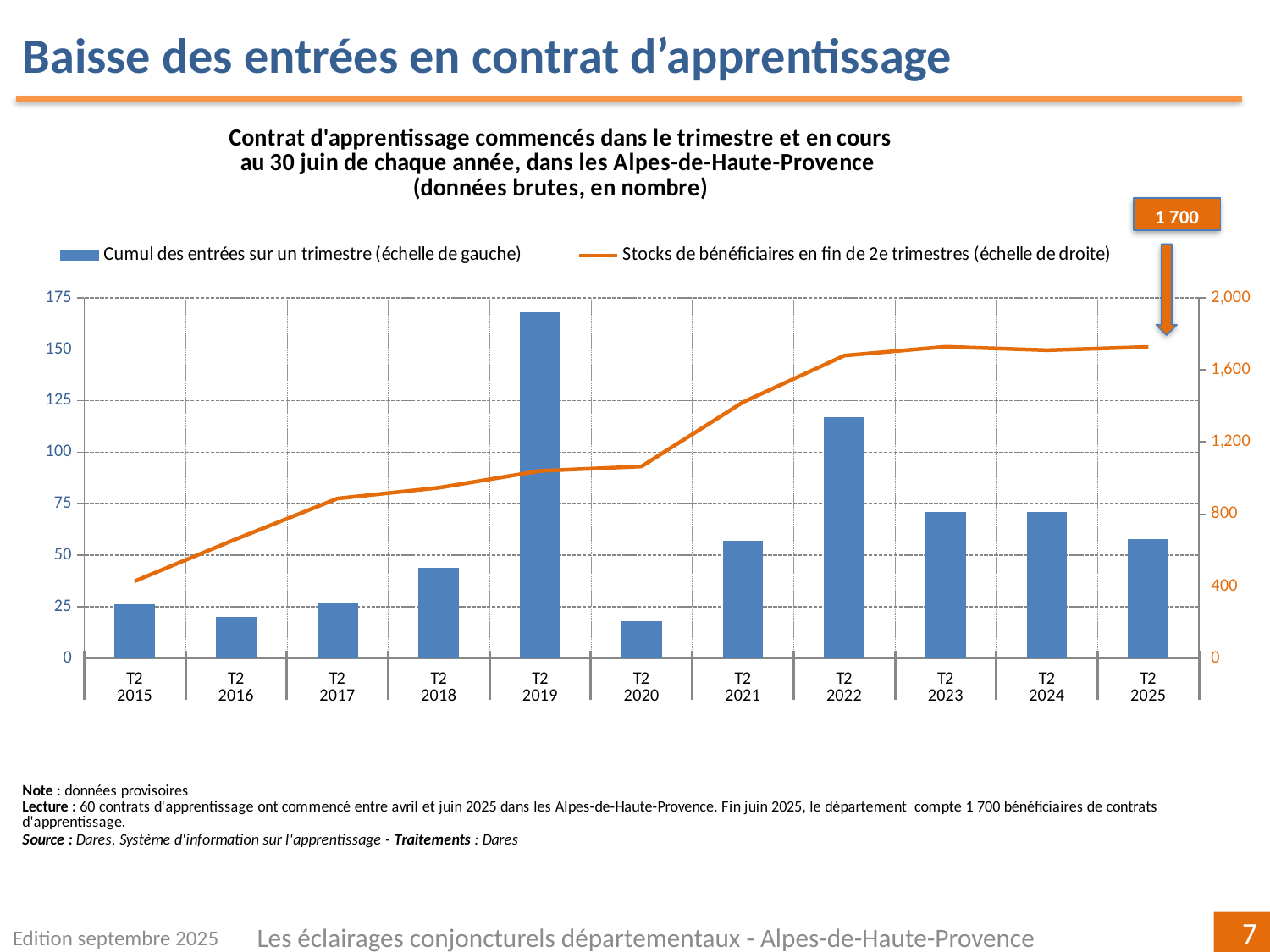
Which quarter has the highest bar for 'Cumul des entrées sur un trimestre'? T2 2019 Is the bar value for T2 2022 greater or less than 100? greater Is the bar value for T2 2016 greater or less than 25? less Which quarter has the lowest bar for 'Cumul des entrées sur un trimestre'? T2 2020 How many series does the chart legend list? 2 Is the bar value for T2 2019 greater or less than 150? greater Which bar is taller: T2 2021 or T2 2022? T2 2022 How many quarters (categories) are shown on the x axis? 11 Does the 'Stocks de bénéficiaires' line generally rise or fall from T2 2015 to T2 2025? rise What is the value of 'Stocks de bénéficiaires en fin de 2e trimestres' at T2 2025, as shown in the callout? 1 700 What kind of chart is shown on the slide? A combined bar and line chart